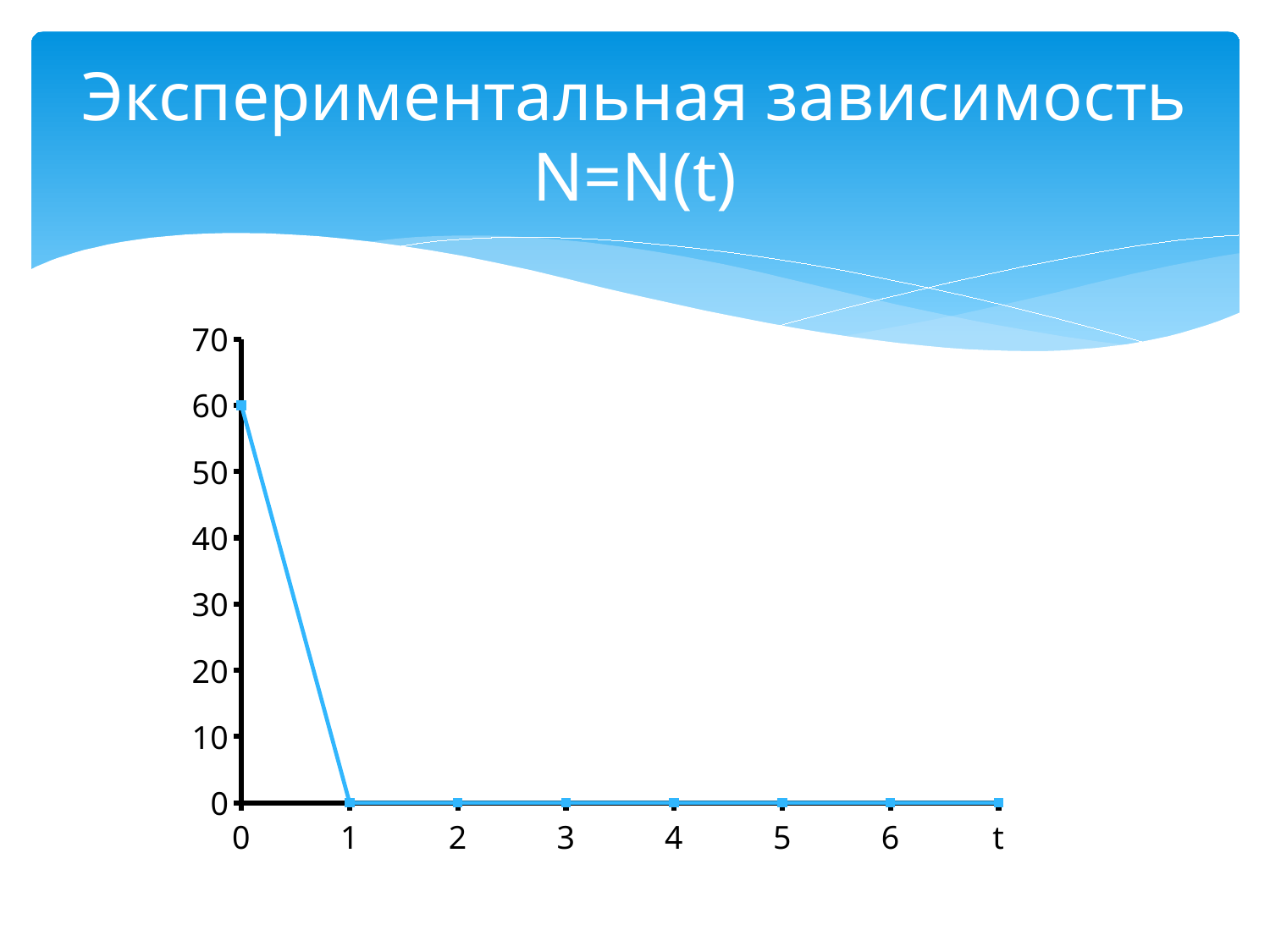
Which is larger, the value of N at t = 0 or at t = 1? t = 0 Do the values rise or fall as t increases from 0 to 1? fall What is the difference between the value of N at t = 0 and at t = 1? 60 At which value of t is N highest? 0 What is the value of N at t = 1? 0 Is the value of N at t = 0 greater or less than 50? greater What is the title of the slide containing the chart? Экспериментальная зависимость N=N(t) What is the value of N at t = 4? 0 Is the value of N at t = 2 greater or less than 10? less How many data points are plotted on the line? 8 What is the value of N at t = 0? 60 What kind of chart is shown on the slide? line chart